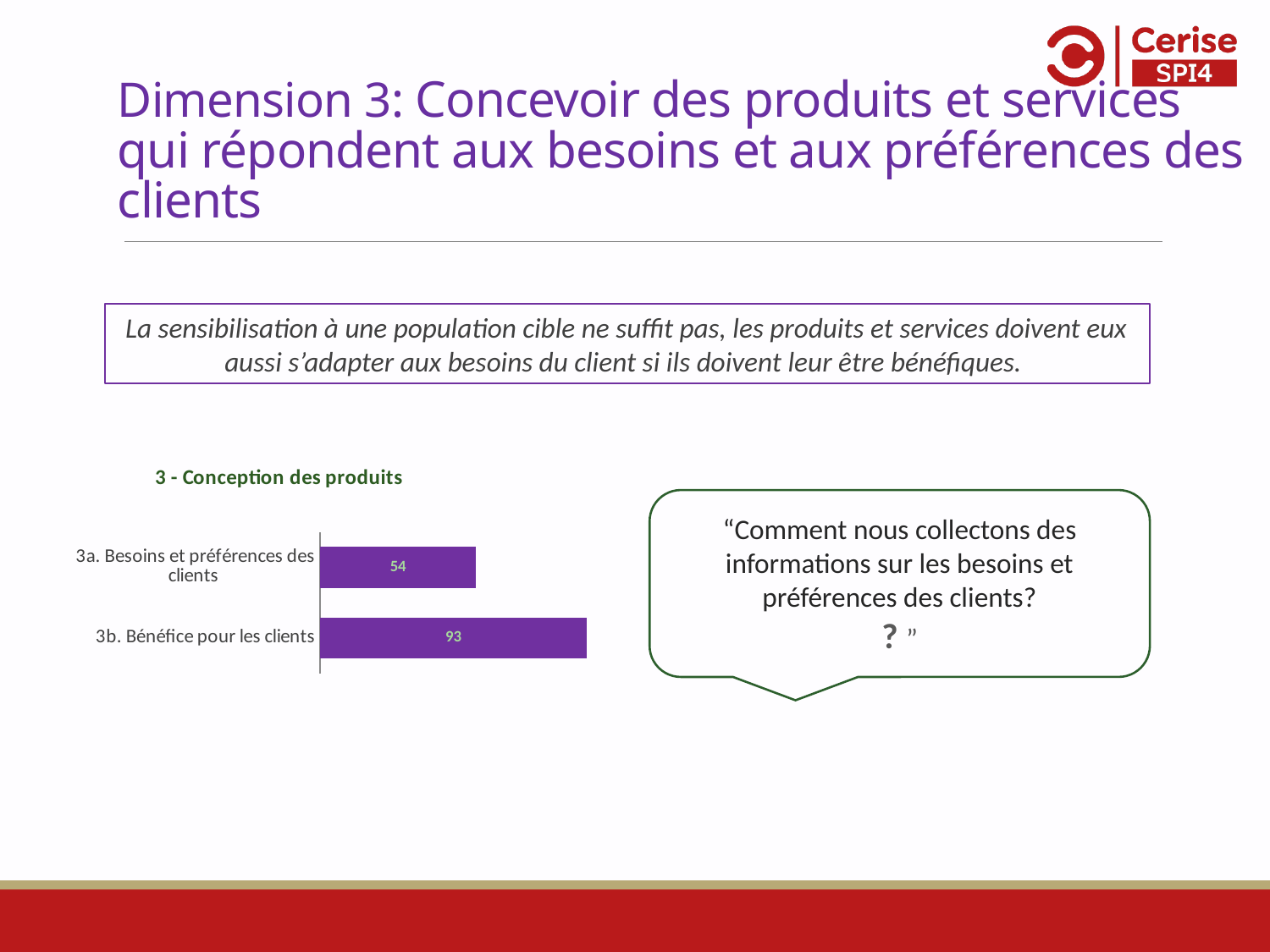
What colour are the bars in the chart? Purple What is the difference between the values for 3b. Bénéfice pour les clients and 3a. Besoins et préférences des clients? 39 What kind of chart is shown on the slide? Bar chart What is the title of the chart? 3 - Conception des produits What is the value for "3a. Besoins et préférences des clients"? 54 Which is larger: the value for 3a. Besoins et préférences des clients or for 3b. Bénéfice pour les clients? 3b. Bénéfice pour les clients Which category has the lowest value? 3a. Besoins et préférences des clients Which category has the highest value? 3b. Bénéfice pour les clients What is the value for "3b. Bénéfice pour les clients"? 93 How many categories are shown in the chart? 2